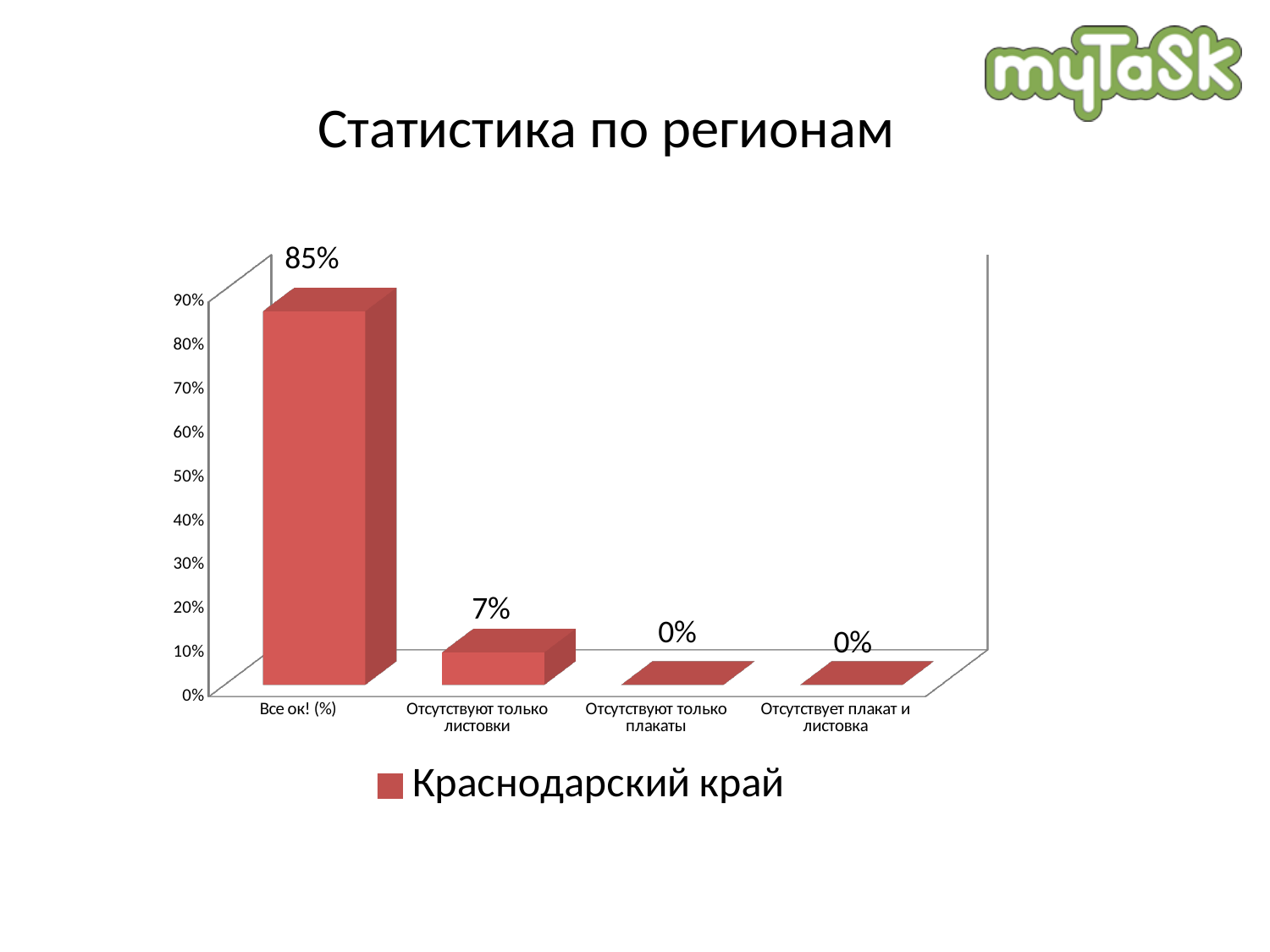
What is the value for "Все ок! (%)"? 85% What is the value for "Отсутствует плакат и листовка"? 0% Which is larger, the value for "Все ок! (%)" or the value for "Отсутствуют только листовки"? Все ок! (%) What kind of chart is shown on the slide? bar chart What is the value for "Отсутствуют только плакаты"? 0% What is the difference between the values for "Все ок! (%)" and "Отсутствуют только листовки"? 78% What series name is shown in the legend? Краснодарский край Is the value for "Все ок! (%)" greater or less than 80%? greater What is the value for "Отсутствуют только листовки"? 7% How many categories are shown on the x axis? 4 Which category has the highest value? Все ок! (%) How many series does the legend list? 1